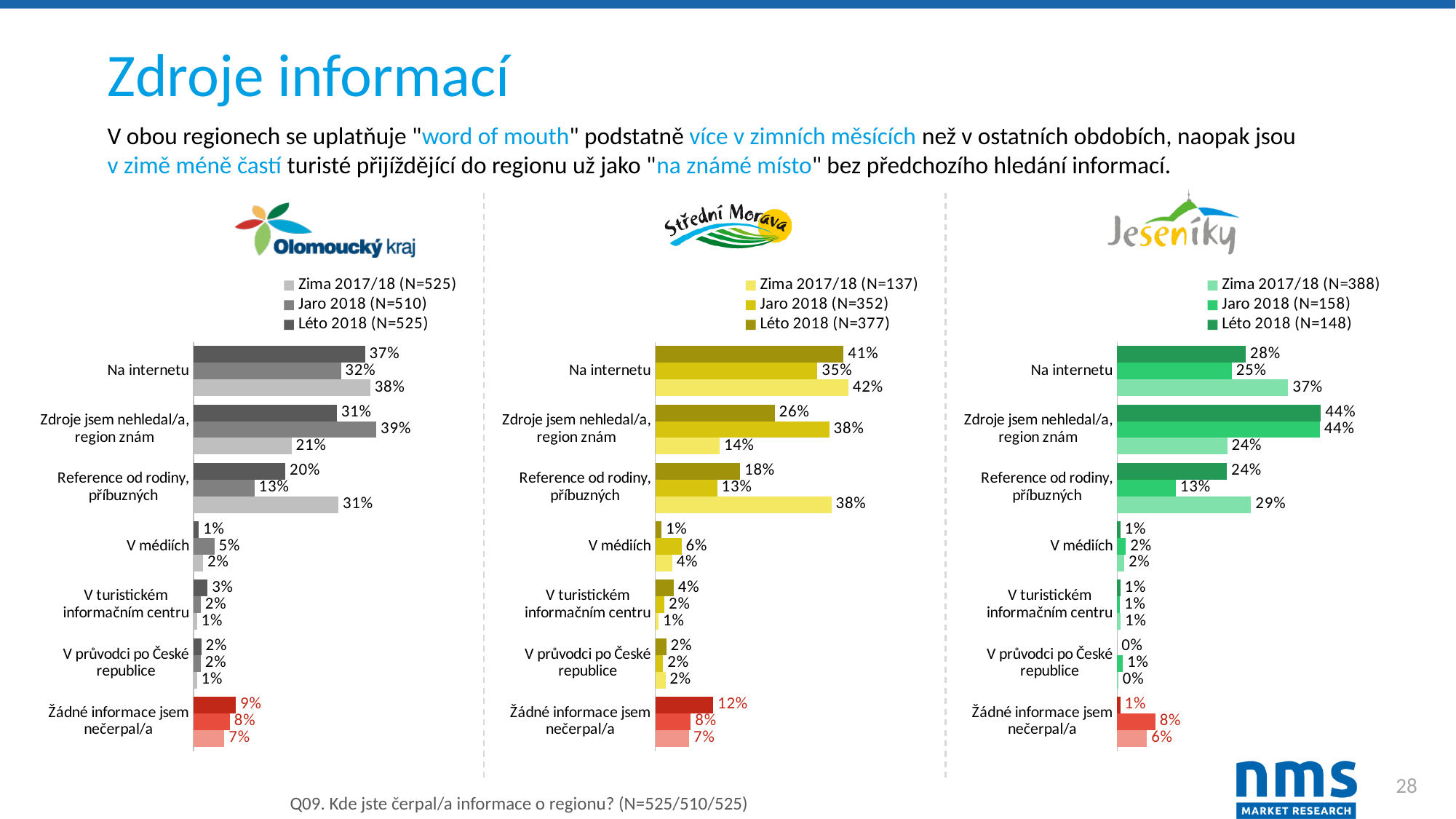
In the Olomoucký kraj chart, which category has the highest value for Jaro 2018? Zdroje jsem nehledal/a, region znám In the Jeseníky chart, what is the value for 'Zdroje jsem nehledal/a, region znám' in Léto 2018? 44% In the Jeseníky chart, which is larger for 'Na internetu': the Zima 2017/18 value or the Léto 2018 value? Zima 2017/18 In the Olomoucký kraj chart, what is the value for 'Na internetu' in Zima 2017/18? 38% In the Střední Morava chart, what is the sample size (N) for Jaro 2018 shown in the legend? 352 In the Střední Morava chart, what is the value for 'Reference od rodiny, příbuzných' in Zima 2017/18? 38% How many categories are shown in the Olomoucký kraj chart? 7 In the Olomoucký kraj chart, what is the value for 'Žádné informace jsem nečerpal/a' in Léto 2018? 9% What kind of chart is the Jeseníky chart? Bar chart In the Střední Morava chart, what is the difference between the Zima 2017/18 and Jaro 2018 values for 'Reference od rodiny, příbuzných'? 25% In the Jeseníky chart, what is the value for 'V průvodci po České republice' in Zima 2017/18? 0% How many series does the legend of the Střední Morava chart list? 3